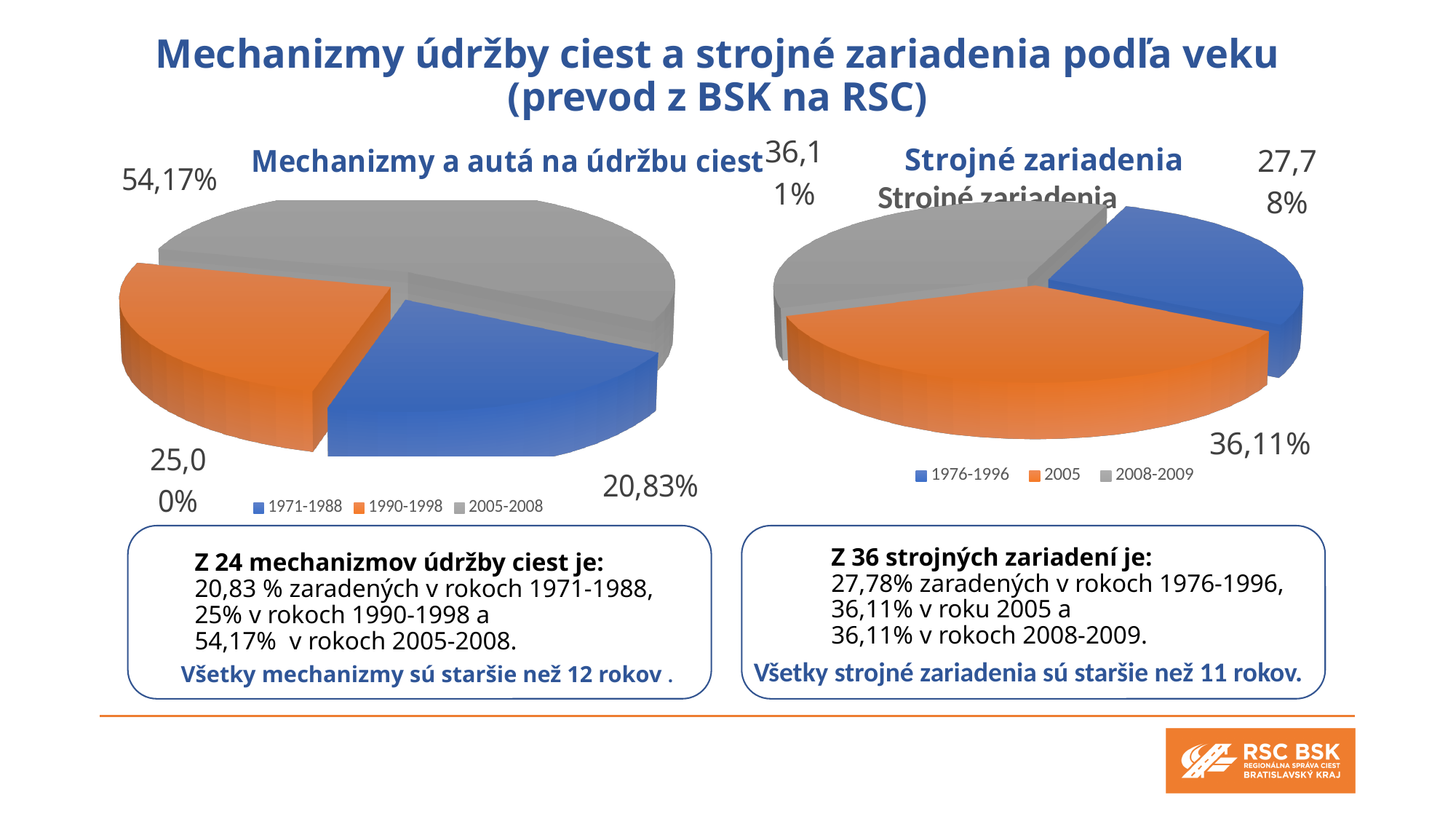
In the chart titled "Strojné zariadenia", which category has the smallest slice? 1976-1996 In the chart titled "Strojné zariadenia", what colour is the 2008-2009 slice? Grey In the chart titled "Mechanizmy a autá na údržbu ciest", what is the value for 1971-1988? 20,83% In the chart titled "Mechanizmy a autá na údržbu ciest", what share of the pie is the 2005-2008 slice? 54,17% In the chart titled "Mechanizmy a autá na údržbu ciest", how many slices does the pie have? 3 What kind of chart is the chart titled "Strojné zariadenia"? Pie chart In the chart titled "Strojné zariadenia", which is larger: the 2005 slice or the 1976-1996 slice? 2005 In the chart titled "Mechanizmy a autá na údržbu ciest", which category has the largest slice? 2005-2008 In the chart titled "Strojné zariadenia", what is the value for 1976-1996? 27,78% In the chart titled "Strojné zariadenia", what is the value for 2005? 36,11% In the chart titled "Mechanizmy a autá na údržbu ciest", what is the difference between the 2005-2008 slice and the 1990-1998 slice? 29,17% In the chart titled "Mechanizmy a autá na údržbu ciest", which category has the smallest slice? 1971-1988